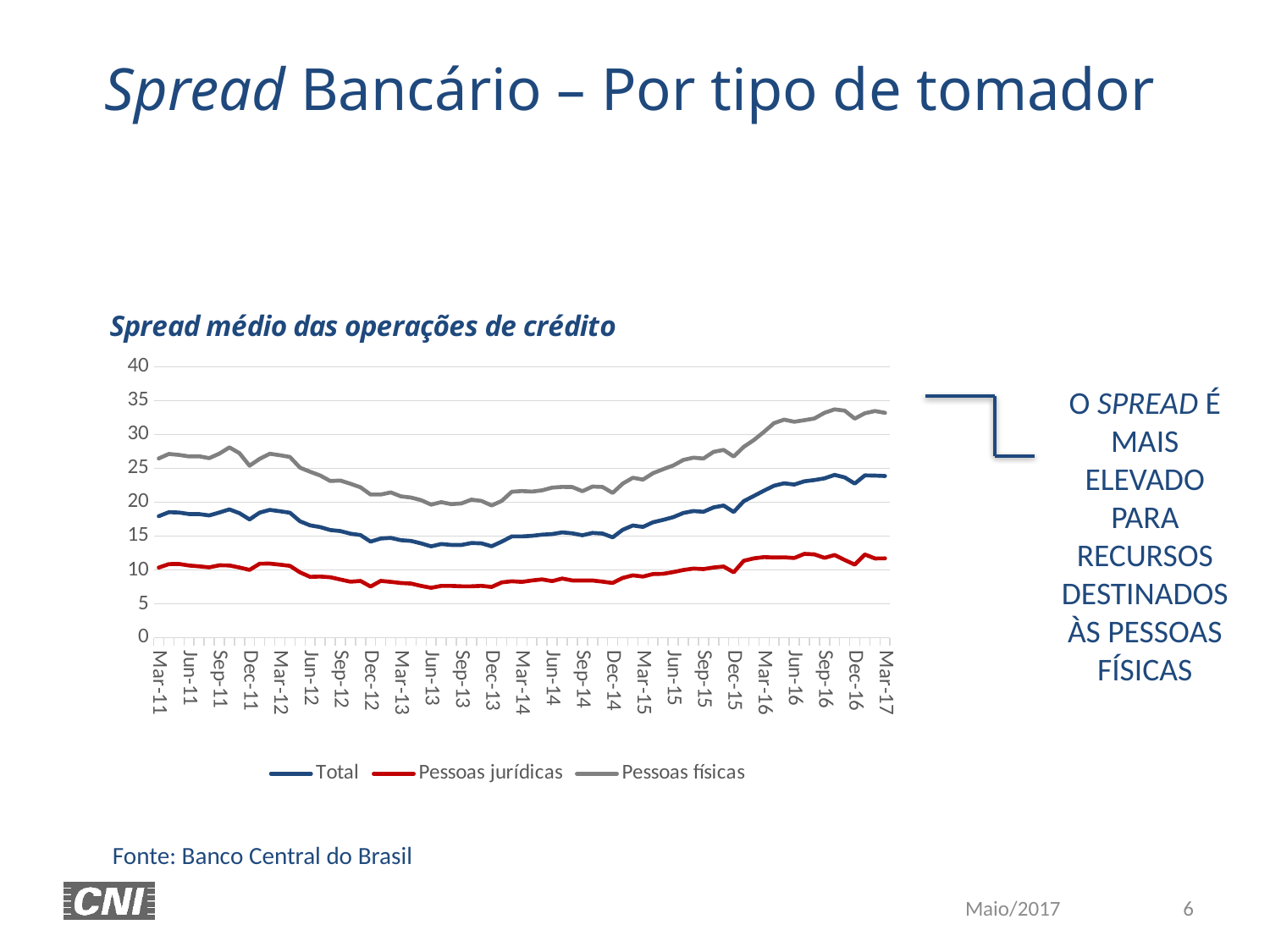
Is the value for Pessoas físicas at Mar-17 greater or less than 30? greater At Mar-17, which is larger: the value for Pessoas físicas or the value for Pessoas jurídicas? Pessoas físicas Which series is plotted in red? Pessoas jurídicas Is the value for Total at Mar-17 greater or less than 20? greater What is the title of the chart? Spread médio das operações de crédito What kind of chart is shown on the slide? line chart Which series has the highest values across the whole period shown? Pessoas físicas How many series does the chart legend list? 3 Is the value for Pessoas jurídicas at Jun-13 greater or less than 10? less Does the Pessoas físicas series rise or fall between Dec-13 and Sep-16? rise Which series has the lowest values across the whole period shown? Pessoas jurídicas